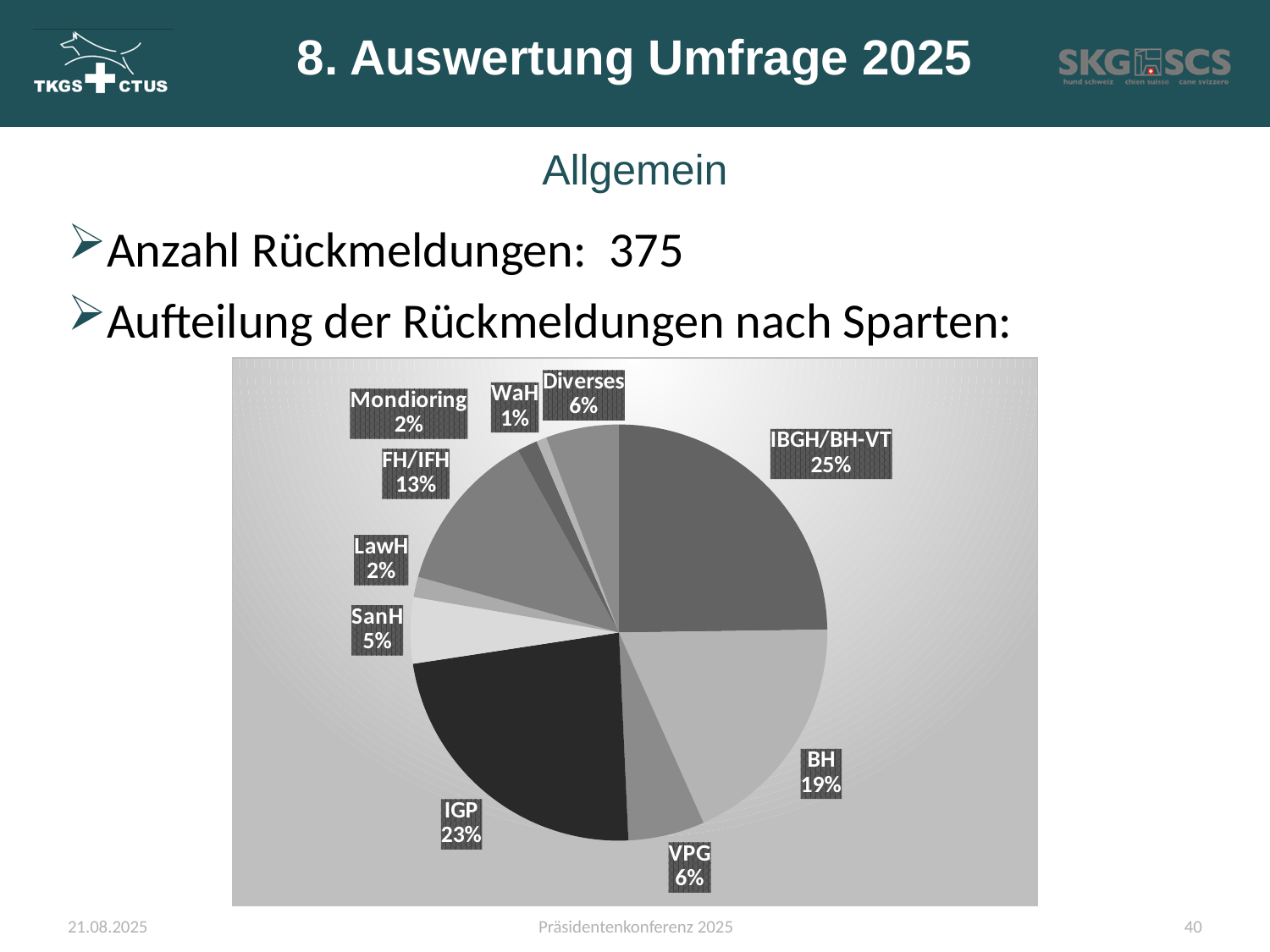
What is the value shown for SanH? 5% What kind of chart is shown on the slide? pie chart Which category has the smallest slice of the pie? WaH Which category has the largest slice of the pie? IBGH/BH-VT What is the difference between the shares of IGP and FH/IFH? 10% Which is larger, the share for BH or the share for IGP? IGP What is the difference between the shares of IBGH/BH-VT and BH? 6% How many categories are shown in the pie chart? 10 Which two categories each have a share of 6%? VPG and Diverses What share of the pie does IBGH/BH-VT have? 25% What is the value shown for IGP? 23% What is the value shown for FH/IFH? 13%